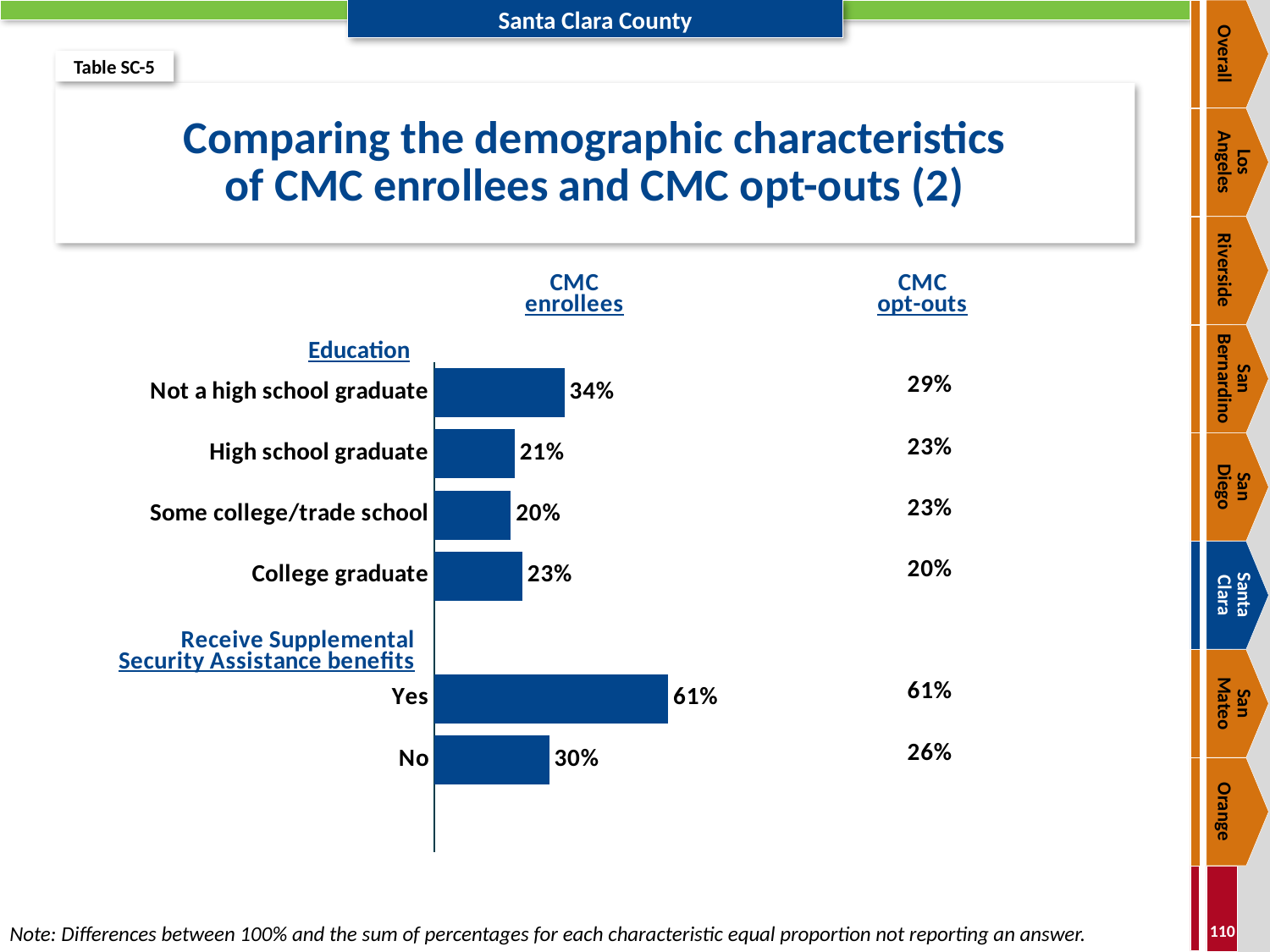
What percentage of CMC enrollees answered Yes to receiving Supplemental Security Assistance benefits? 61% What percentage of CMC opt-outs are not a high school graduate? 29% Among the education categories, which has the lowest percentage of CMC enrollees? Some college/trade school What percentage of CMC enrollees are not a high school graduate? 34% What is the title of the slide's chart? Comparing the demographic characteristics of CMC enrollees and CMC opt-outs (2) What percentage of CMC enrollees are college graduates? 23% Which is larger: the percentage of CMC enrollees who are college graduates or the percentage of CMC enrollees who are high school graduates? College graduates What type of chart is used to show the CMC enrollees percentages? Bar chart How many bars are plotted in the CMC enrollees chart? 6 What is the difference between the percentage of CMC enrollees and CMC opt-outs who are not a high school graduate? 5% Among the education categories, which has the highest percentage of CMC enrollees? Not a high school graduate What is the difference between the percentage of CMC enrollees who receive Supplemental Security Assistance benefits (Yes) and those who do not (No)? 31%